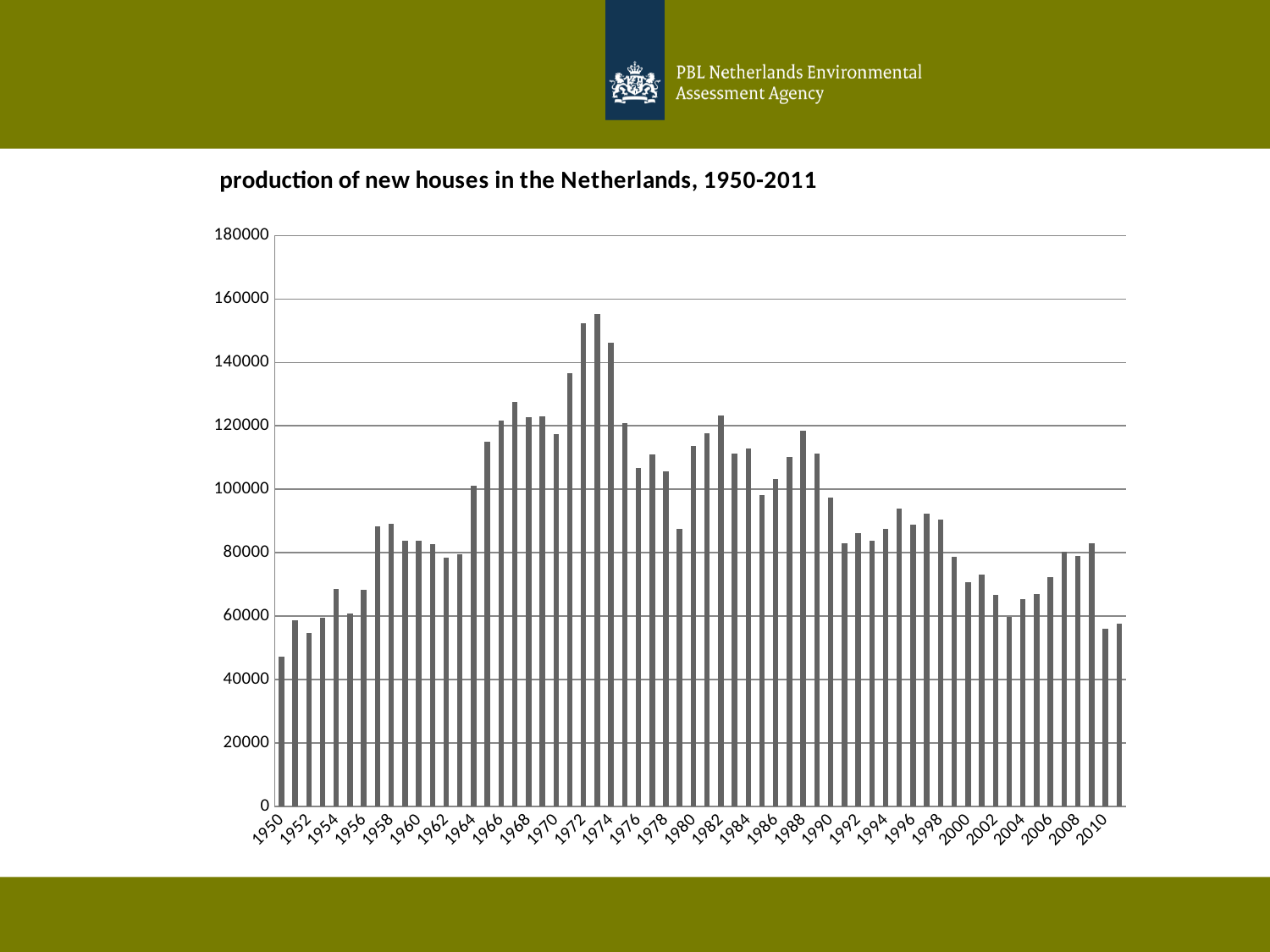
Is the value for 2000 greater or less than 80000? less Which year has a larger value, 1965 or 1995? 1965 Is the value for 1973 greater or less than 140000? greater How many years (bars) are plotted in the chart? 62 Which year has the lowest production of new houses? 1950 Is the value for 1950 greater or less than 60000? less Which year has the highest production of new houses? 1973 What is the title of the chart? production of new houses in the Netherlands, 1950-2011 Do the values generally rise or fall from 1950 to 1973? rise What kind of chart is shown on the slide? bar chart What is the highest value shown on the vertical axis? 180000